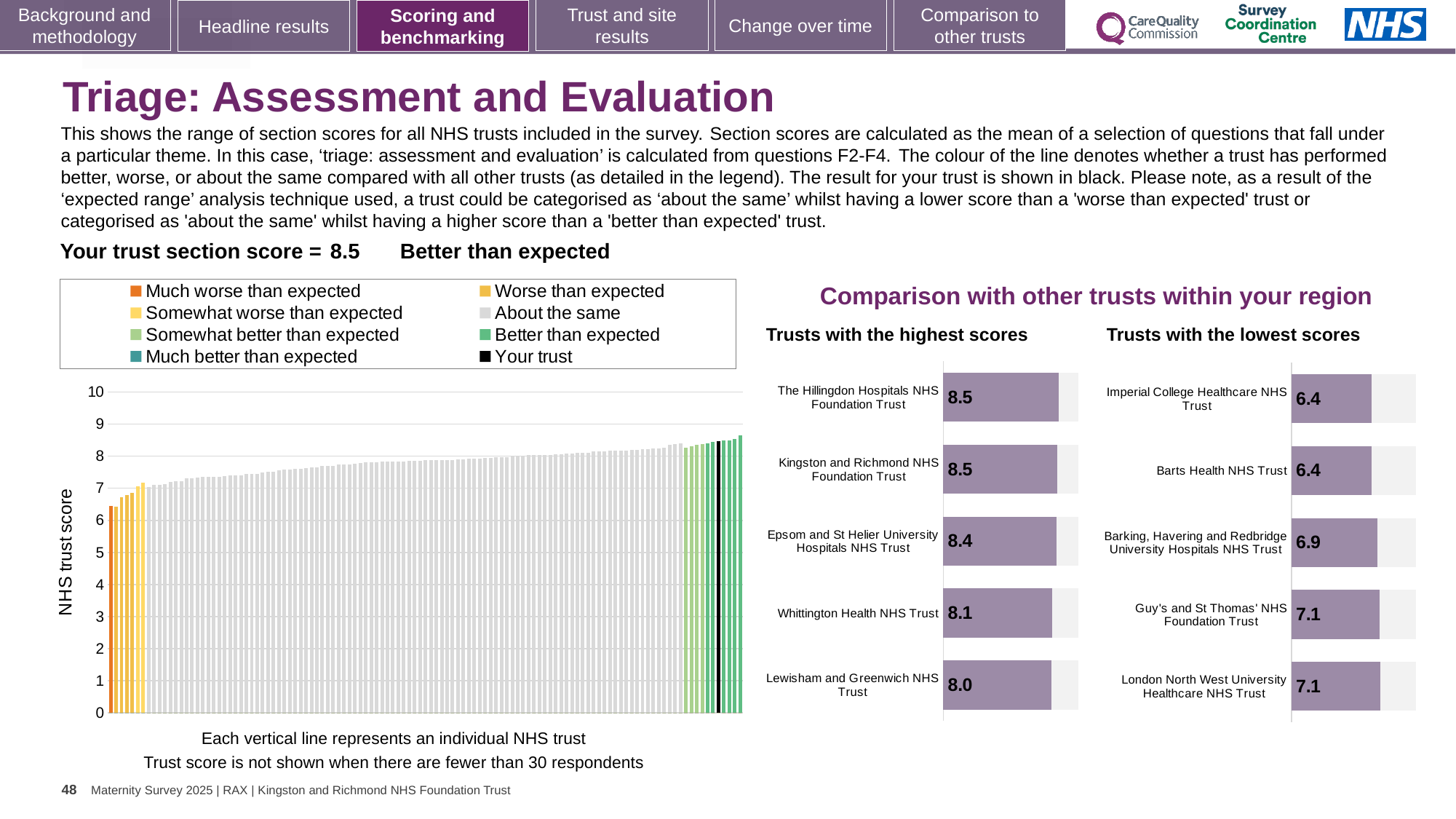
In the large 'NHS trust score' chart on the left, is the value of the black bar (your trust) greater or less than 8? greater In the 'Trusts with the highest scores' chart, what is the score for Lewisham and Greenwich NHS Trust? 8.0 How many trusts are listed in the 'Trusts with the lowest scores' chart? 5 In the 'Trusts with the lowest scores' chart, what is the difference between the score for London North West University Healthcare NHS Trust and the score for Imperial College Healthcare NHS Trust? 0.7 In the 'Trusts with the highest scores' chart, what is the difference between the score for The Hillingdon Hospitals NHS Foundation Trust and the score for Lewisham and Greenwich NHS Trust? 0.5 In the 'Trusts with the lowest scores' chart, what is the score for Guy's and St Thomas' NHS Foundation Trust? 7.1 In the 'Trusts with the lowest scores' chart, which has the higher score: Barts Health NHS Trust or Barking, Havering and Redbridge University Hospitals NHS Trust? Barking, Havering and Redbridge University Hospitals NHS Trust In the 'Trusts with the lowest scores' chart, what is the score for Barking, Havering and Redbridge University Hospitals NHS Trust? 6.9 In the 'Trusts with the highest scores' chart, what is the score for Epsom and St Helier University Hospitals NHS Trust? 8.4 How many entries does the legend of the large chart on the left list? 8 In the large 'NHS trust score' chart on the left, do the bar values rise or fall from left to right? rise In the 'Trusts with the highest scores' chart, which has the higher score: Epsom and St Helier University Hospitals NHS Trust or Whittington Health NHS Trust? Epsom and St Helier University Hospitals NHS Trust